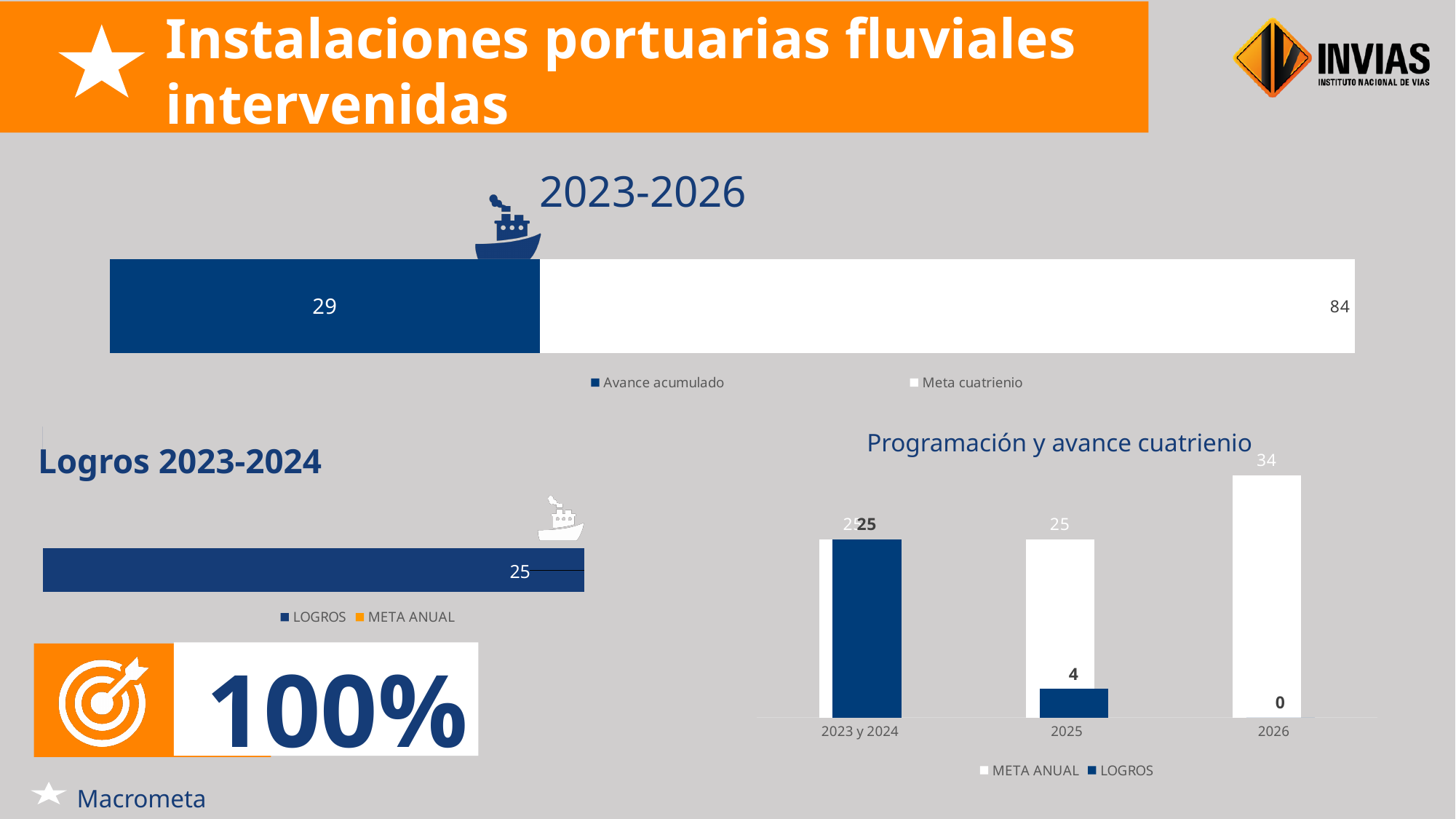
In the '2023-2026' chart, what is the difference between Meta cuatrienio and Avance acumulado? 55 What kind of chart is 'Programación y avance cuatrienio'? bar chart In the 'Programación y avance cuatrienio' chart, what is the LOGROS value for 2026? 0 In the 'Programación y avance cuatrienio' chart, what is the LOGROS value for 2025? 4 In the 'Programación y avance cuatrienio' chart, what is the META ANUAL value for 2026? 34 In the 'Programación y avance cuatrienio' chart, how many categories are shown on the x axis? 3 In the 'Programación y avance cuatrienio' chart, which category has the highest META ANUAL value? 2026 In the 'Programación y avance cuatrienio' chart, do the LOGROS values rise or fall from 2023 y 2024 to 2026? fall In the '2023-2026' chart, what is the value for Meta cuatrienio? 84 In the 'Logros 2023-2024' chart, what is the value for LOGROS? 25 In the '2023-2026' chart, what is the value for Avance acumulado? 29 In the '2023-2026' chart, how many series does the legend list? 2